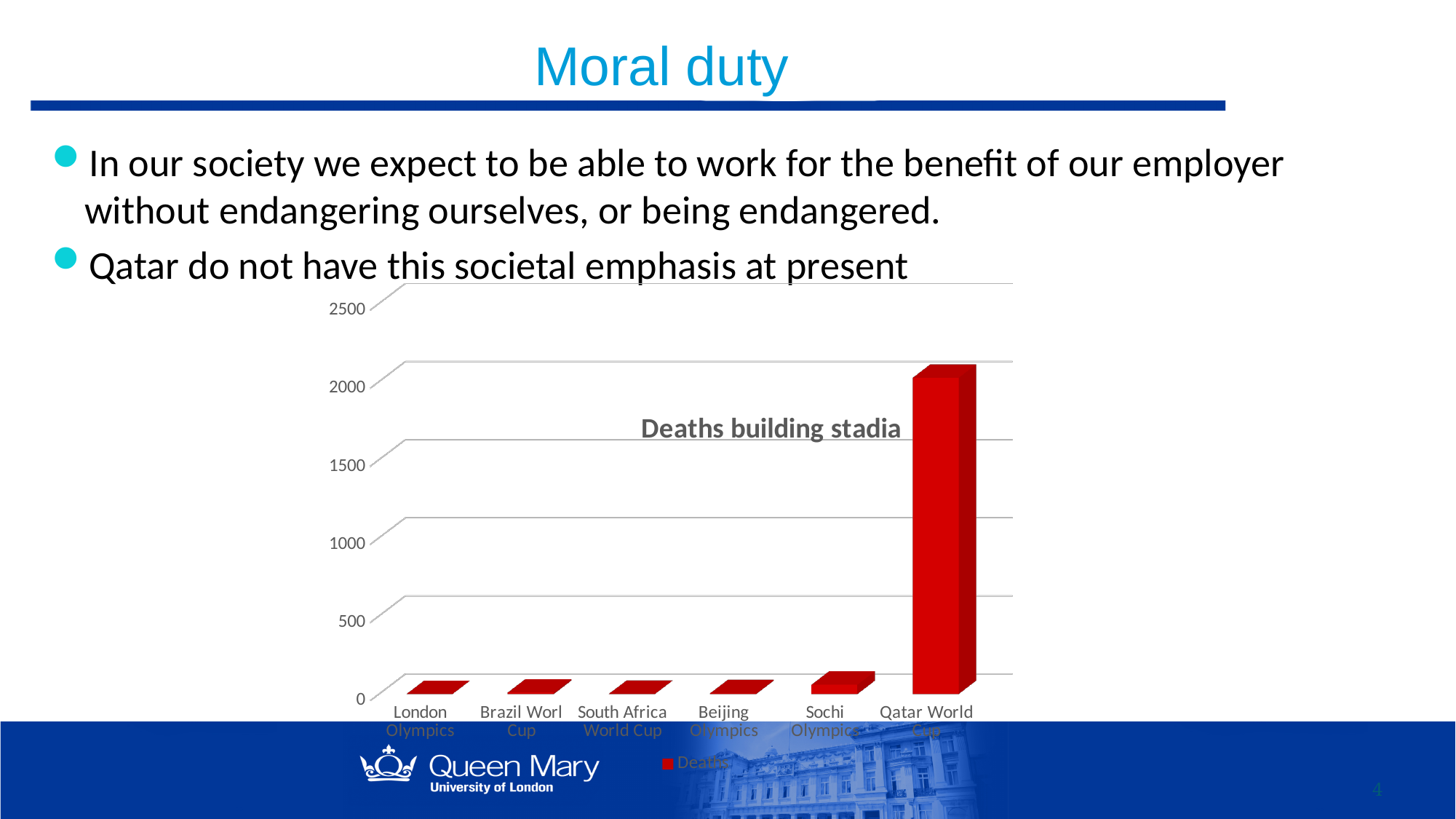
What kind of chart is shown on the slide? bar chart How many categories are shown on the x axis of the chart? 6 What is the title of the chart? Deaths building stadia Which is larger, the value for Qatar World Cup or the value for Brazil World Cup? Qatar World Cup How many series does the chart legend list? 1 What is the name of the series in the chart legend? Deaths Which category has the highest value in the chart? Qatar World Cup Is the value for Sochi Olympics greater or less than 500? less Is the value for Beijing Olympics greater or less than 1000? less Is the value for Qatar World Cup greater or less than 1500? greater Which is larger, the value for Qatar World Cup or the value for Sochi Olympics? Qatar World Cup